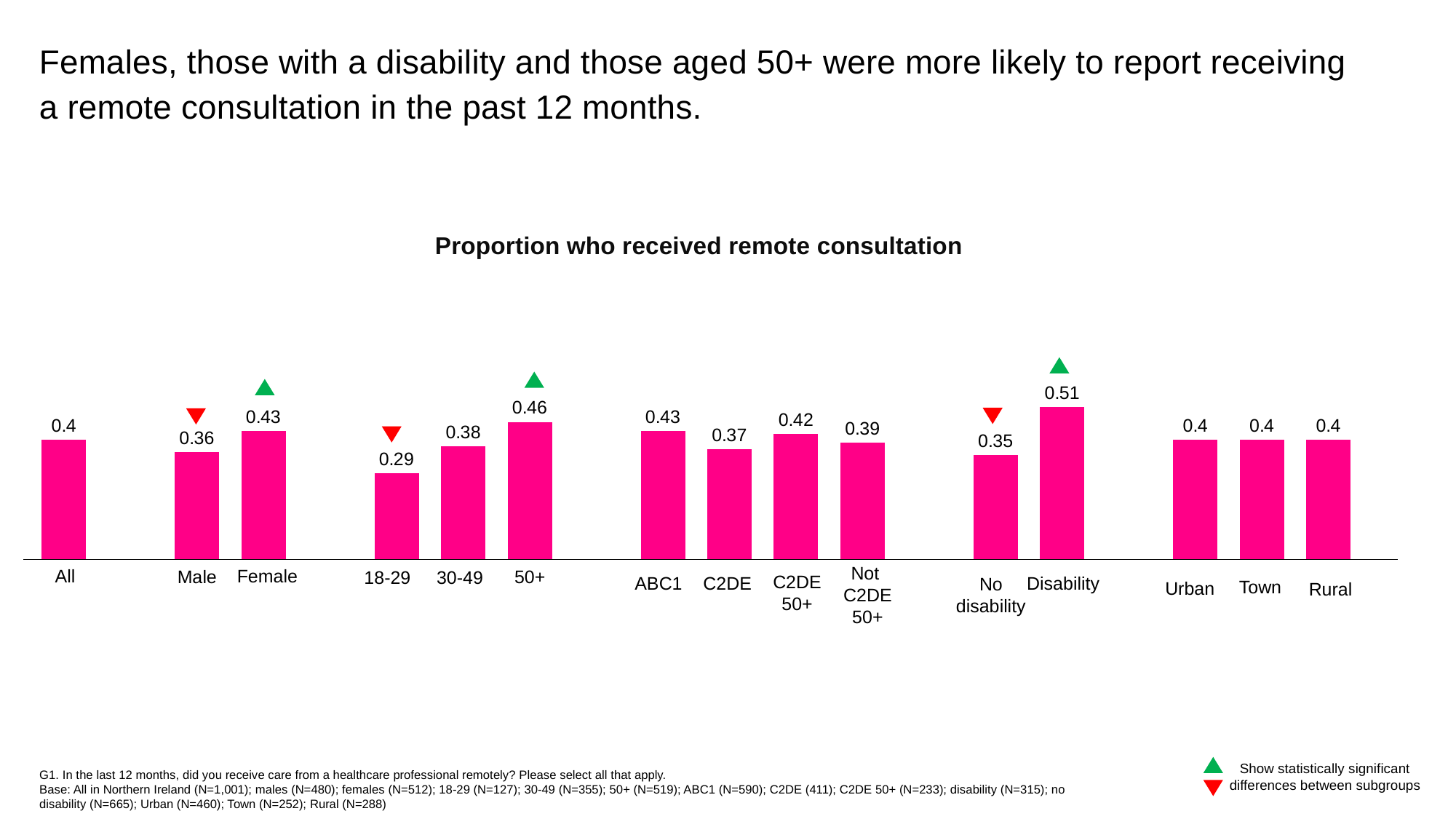
What is the title of the chart? Proportion who received remote consultation What is the value for 18-29 in the chart? 0.29 Which category has the highest value in the chart? Disability What is the value for C2DE 50+ in the chart? 0.42 What is the value for Female in the chart? 0.43 How many bars are plotted in the chart? 15 What is the value for Disability in the chart? 0.51 What type of chart is shown on the slide? Bar chart What is the difference between the values for Disability and No disability? 0.16 What is the difference between the values for 50+ and 18-29? 0.17 Which category has the lowest value in the chart? 18-29 Which is larger, the value for Male or the value for Female? Female